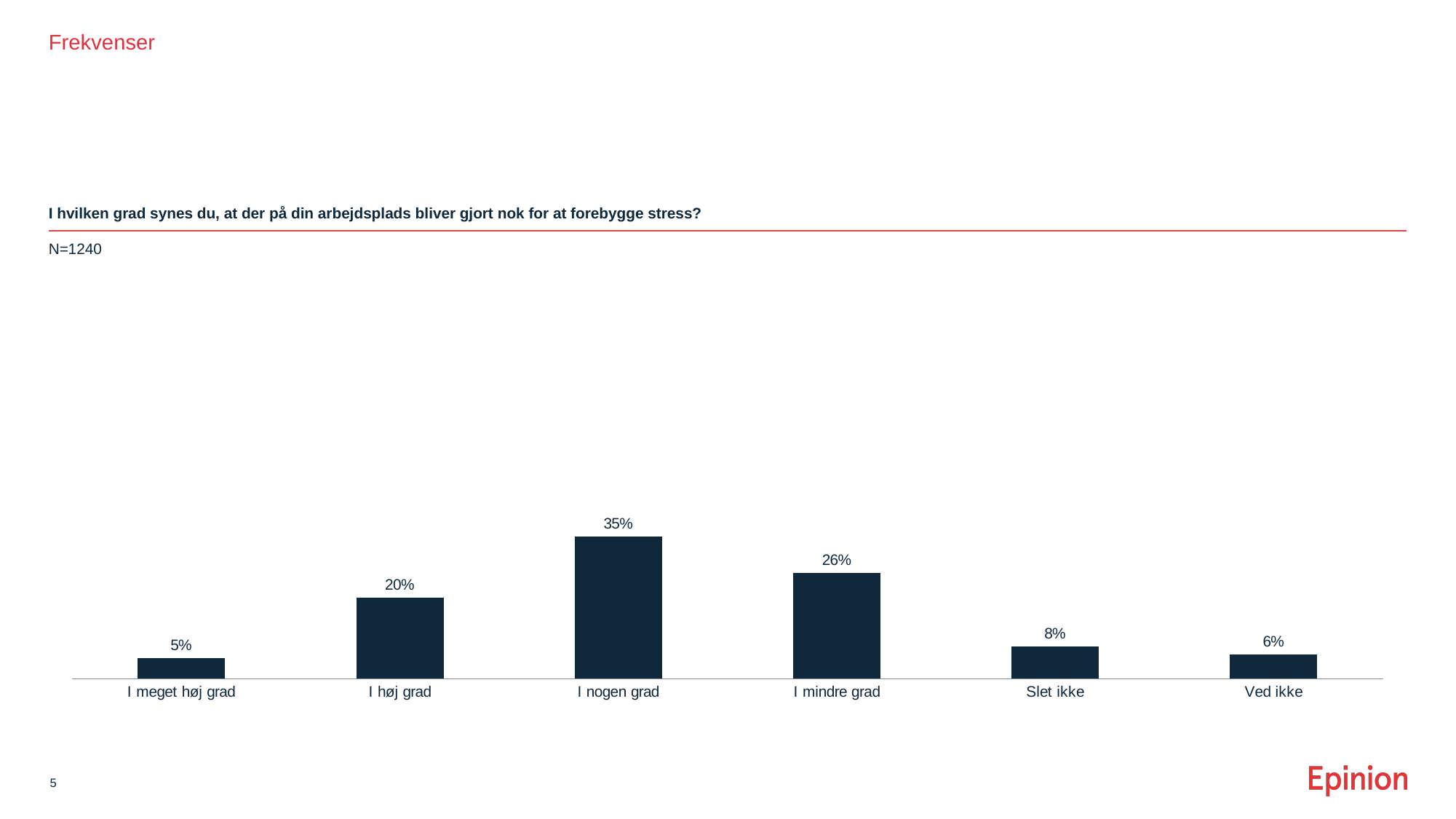
What is the value for "I meget høj grad"? 5% Which category has the lowest value? I meget høj grad Which category has the highest value? I nogen grad What is the sample size (N) stated above the chart? N=1240 What is the difference between "I nogen grad" and "I mindre grad"? 9% What is the value for "I nogen grad"? 35% What kind of chart is shown on the slide? Bar chart How many categories are shown on the x axis? 6 Which is larger, "I høj grad" or "I mindre grad"? I mindre grad What is the value for "Ved ikke"? 6% What is the difference between "I høj grad" and "I meget høj grad"? 15% What is the value for "Slet ikke"? 8%